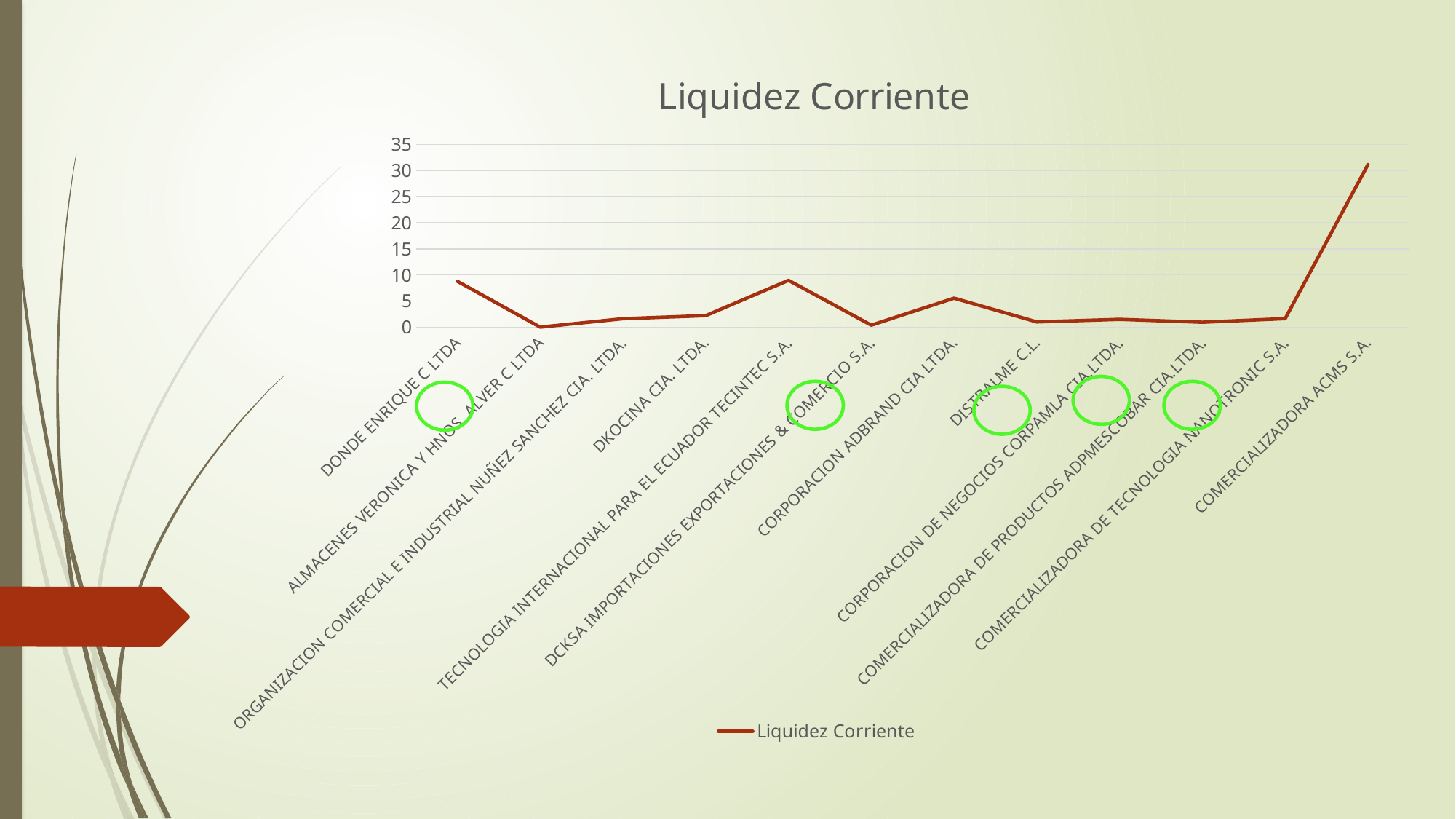
Is the value for TECNOLOGIA INTERNACIONAL PARA EL ECUADOR TECINTEC S.A. greater or less than 15? less Which has the larger value, TECNOLOGIA INTERNACIONAL PARA EL ECUADOR TECINTEC S.A. or DCKSA IMPORTACIONES EXPORTACIONES & COMERCIO S.A.? TECNOLOGIA INTERNACIONAL PARA EL ECUADOR TECINTEC S.A. What is the name of the series shown in the legend? Liquidez Corriente Is the value for DONDE ENRIQUE C LTDA greater or less than 10? less Which company has the highest Liquidez Corriente value? COMERCIALIZADORA ACMS S.A. Which has the larger value, DONDE ENRIQUE C LTDA or DKOCINA CIA. LTDA.? DONDE ENRIQUE C LTDA Is the value for COMERCIALIZADORA ACMS S.A. greater or less than 25? greater What is the title of the chart? Liquidez Corriente How many series does the legend list? 1 How many companies are plotted along the x axis? 12 What kind of chart is shown on the slide? line chart